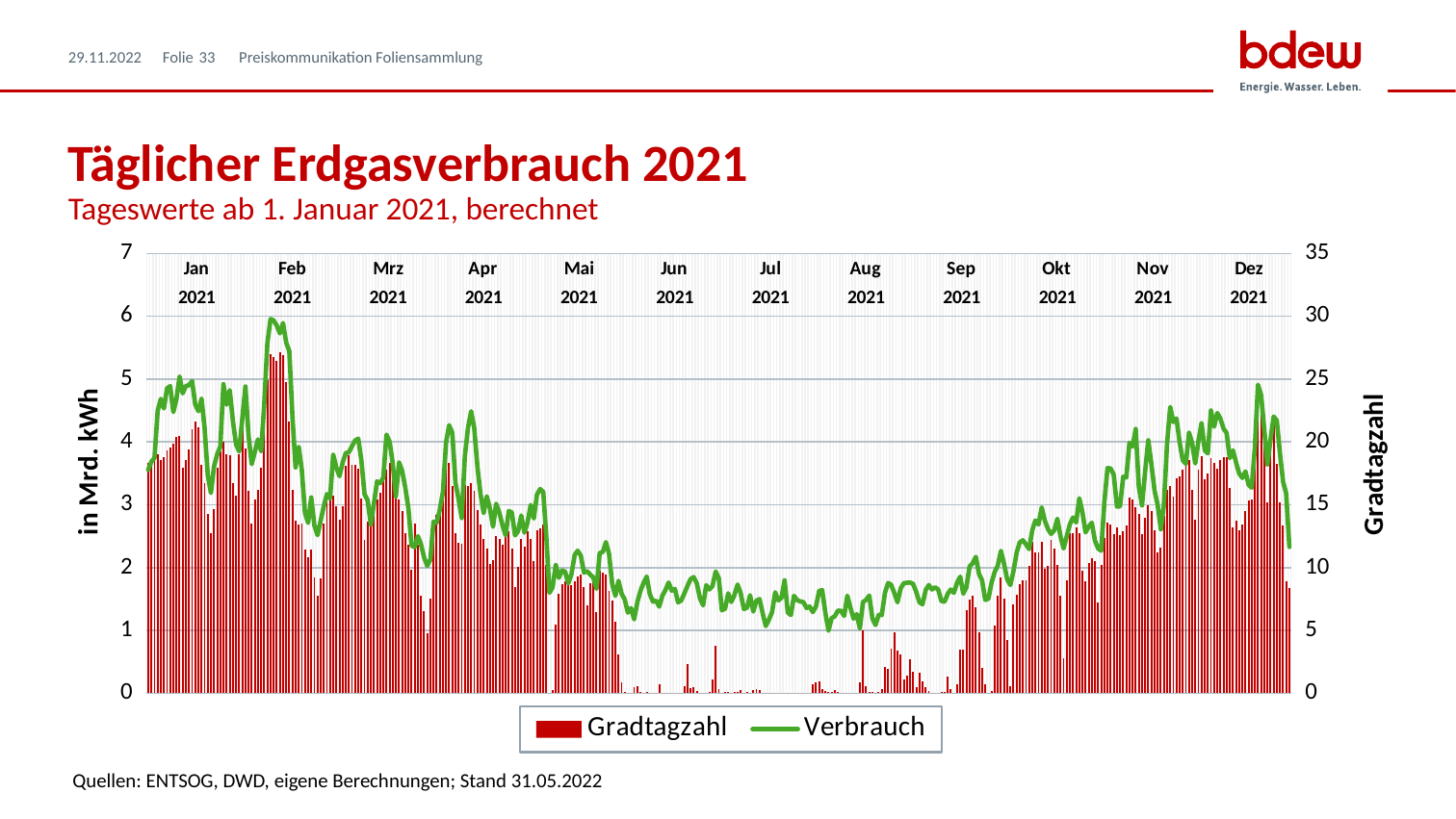
What is the title of the chart on the slide? Täglicher Erdgasverbrauch 2021 Is the peak Verbrauch value in February 2021 greater or less than 5 Mrd. kWh? greater In which month does the Verbrauch line reach its highest peak? Feb 2021 Which colour is used for the Verbrauch series? Green Which is larger, the Verbrauch value in February 2021 or in July 2021? February 2021 What kind of chart is shown on the slide? A combined bar and line chart Is the Verbrauch value in mid-July 2021 greater or less than 2 Mrd. kWh? less How many series does the legend list? 2 Does the Verbrauch line rise or fall from August to November 2021? rise Is the highest Gradtagzahl bar in February 2021 greater or less than 25 on the right axis? greater Does the Verbrauch line rise or fall from February to July 2021? fall How many months are labelled along the x axis? 12